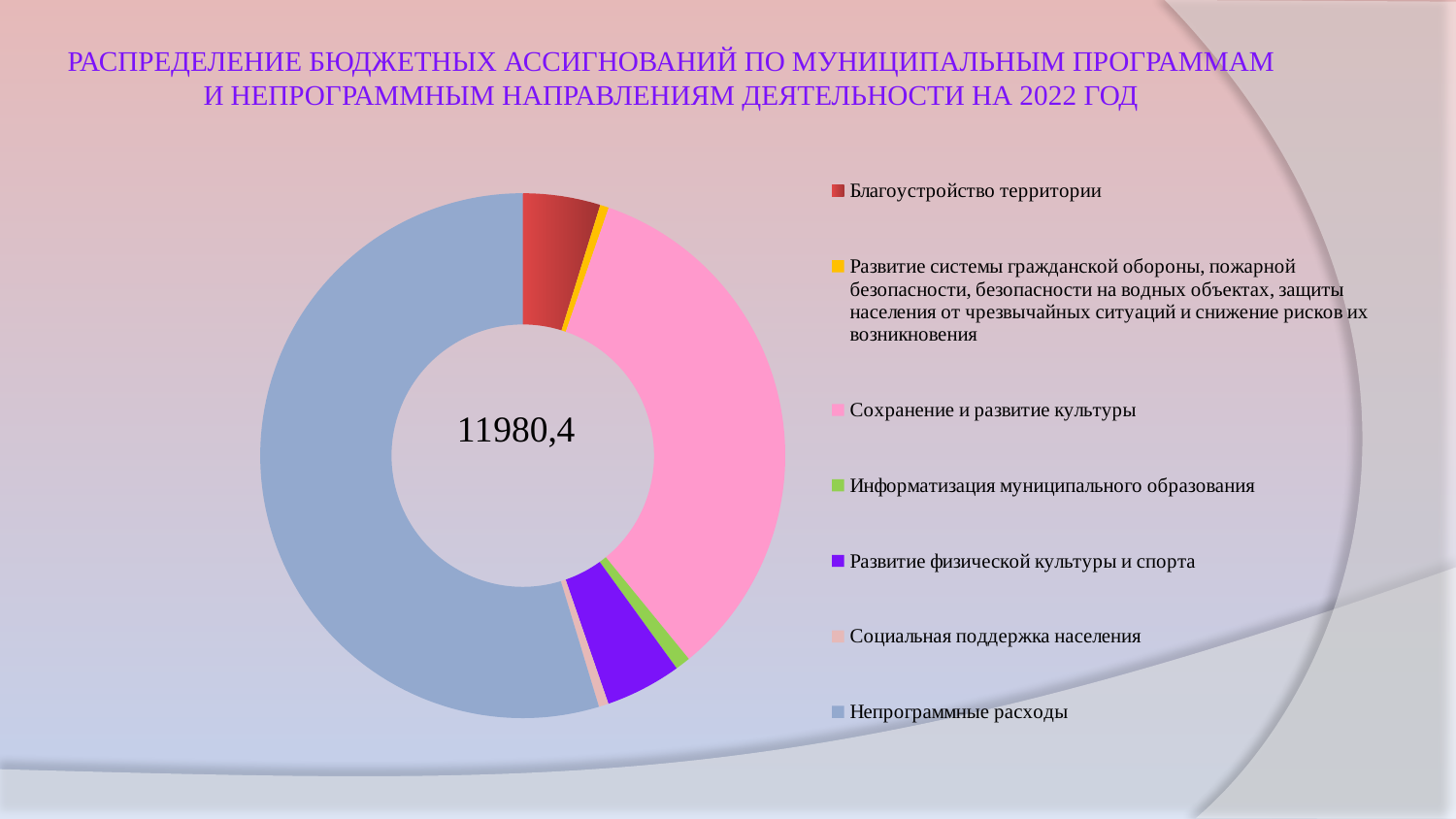
Which has the larger share: Сохранение и развитие культуры or Развитие физической культуры и спорта? Сохранение и развитие культуры Which has the larger share: Благоустройство территории or Информатизация муниципального образования? Благоустройство территории Which has the larger share: Развитие физической культуры и спорта or Социальная поддержка населения? Развитие физической культуры и спорта How many categories does the legend of the chart list? 7 What value is printed in the centre of the doughnut chart? 11980,4 Which category has the largest share of the chart? Непрограммные расходы What colour represents Сохранение и развитие культуры in the chart? Pink What kind of chart is shown on the slide? Doughnut (pie) chart